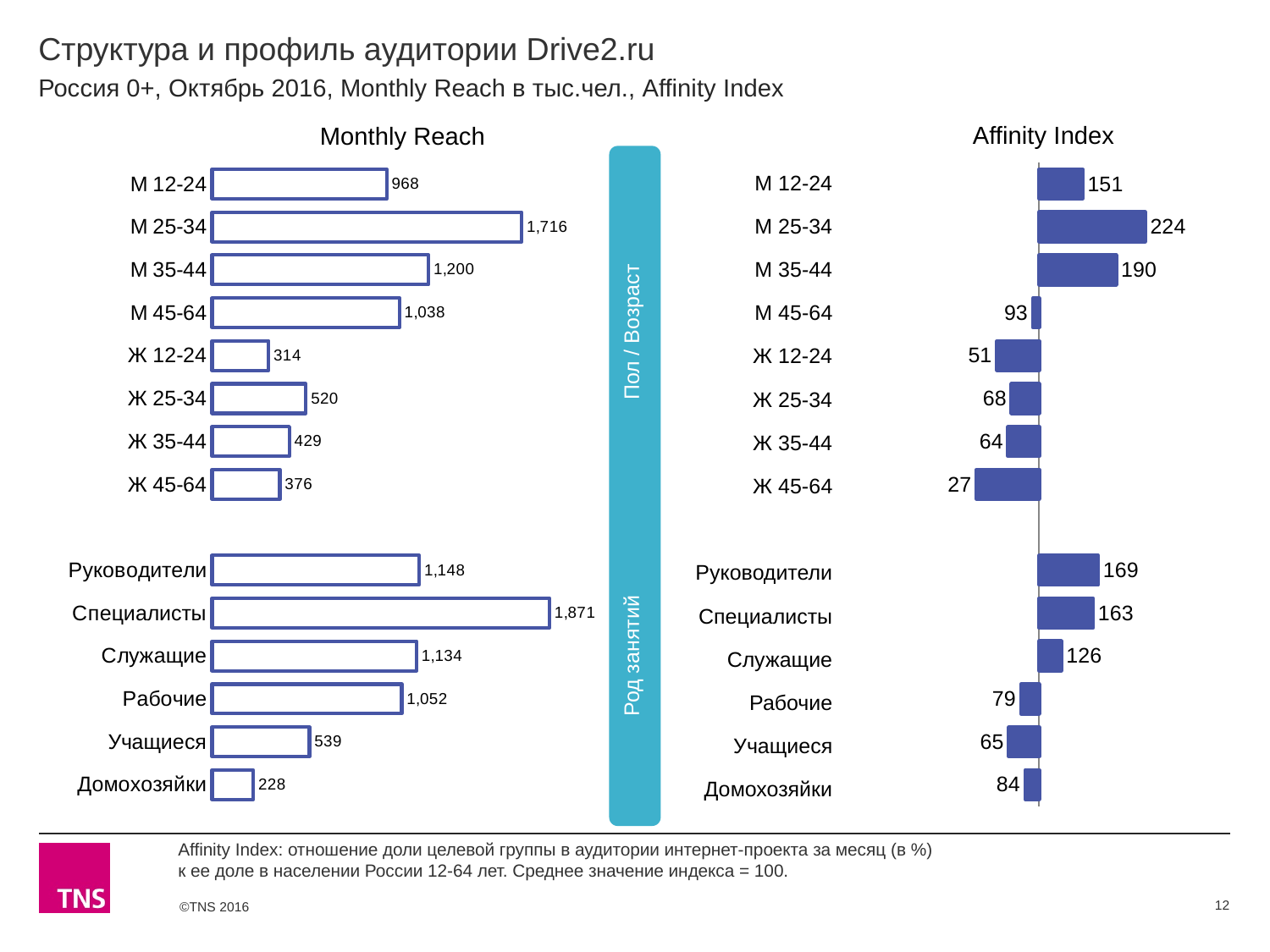
In the Affinity Index chart, what is the value for Ж 45-64? 27 What kind of chart is the Affinity Index chart? Bar chart In the Monthly Reach chart, what is the difference between М 35-44 and М 45-64? 162 In the Affinity Index chart, which category has the lowest value? Ж 45-64 In the Monthly Reach chart, which is larger: Ж 25-34 or Учащиеся? Учащиеся In the Affinity Index chart, what is the difference between Руководители and Специалисты? 6 How many categories are shown in the Monthly Reach chart? 14 In the Affinity Index chart, what is the value for Служащие? 126 In the Monthly Reach chart, which category has the highest value? Специалисты In the Monthly Reach chart, what is the value for Домохозяйки? 228 In the Monthly Reach chart, what is the value for М 25-34? 1,716 In the Affinity Index chart, which category has the highest value? М 25-34